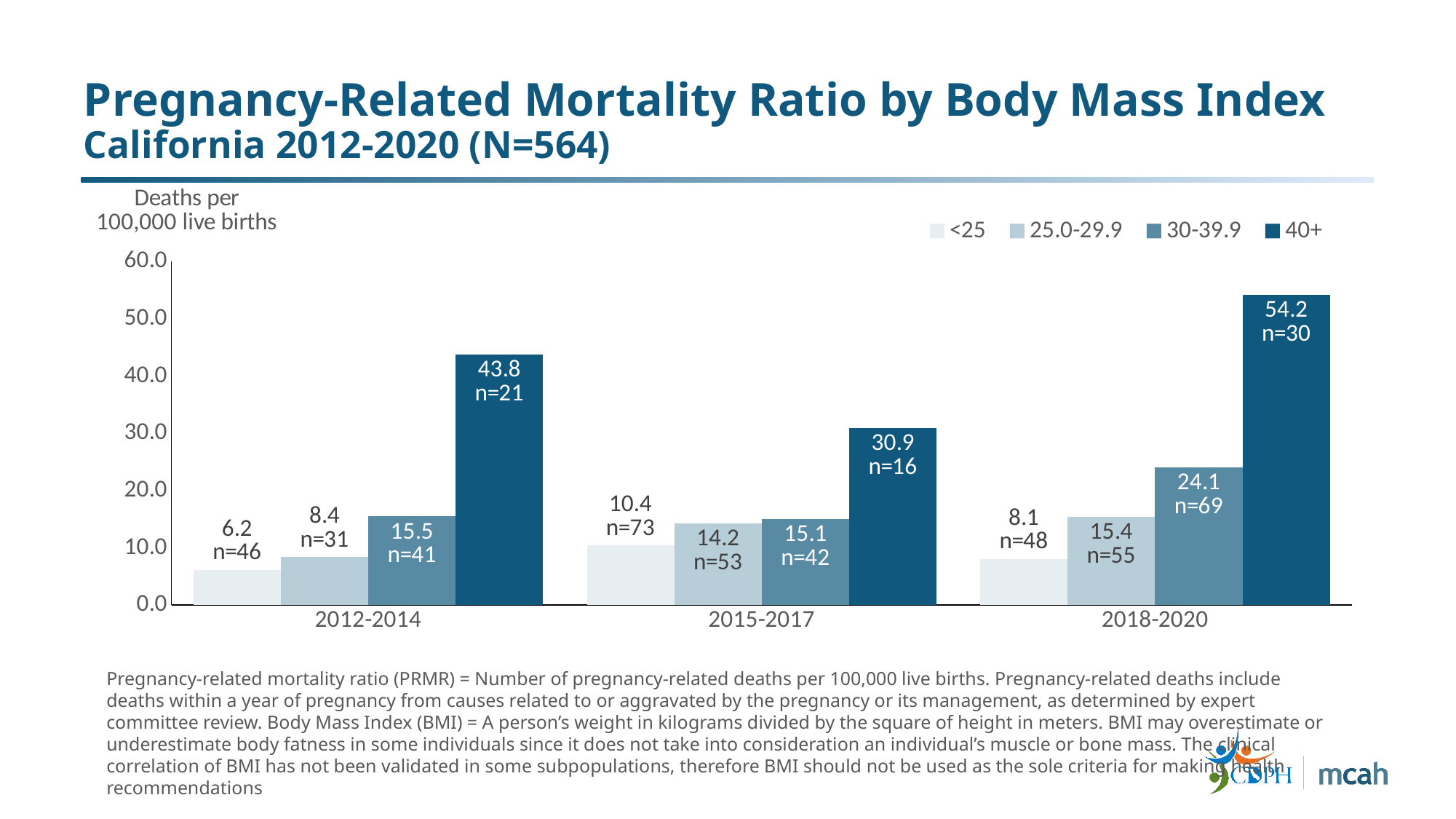
What is the difference between the 40+ group's value in 2018-2020 and its value in 2012-2014? 10.4 How many deaths (n) are reported for the 30-39.9 BMI group in 2018-2020? n=69 What is the pregnancy-related mortality ratio for the <25 BMI group in 2012-2014? 6.2 What is the pregnancy-related mortality ratio for the 40+ BMI group in 2018-2020? 54.2 Which BMI group has the lowest mortality ratio in 2018-2020? <25 Which BMI group has the highest mortality ratio in 2012-2014? 40+ Is the value for the 40+ group in 2015-2017 greater or less than 40.0? less What kind of chart is shown on the slide? Bar chart How many time periods are shown on the x axis? 3 Which is larger: the 30-39.9 group's value in 2012-2014 or in 2015-2017? 2012-2014 How many BMI groups does the legend list? 4 What is the value for the 25.0-29.9 BMI group in 2015-2017? 14.2